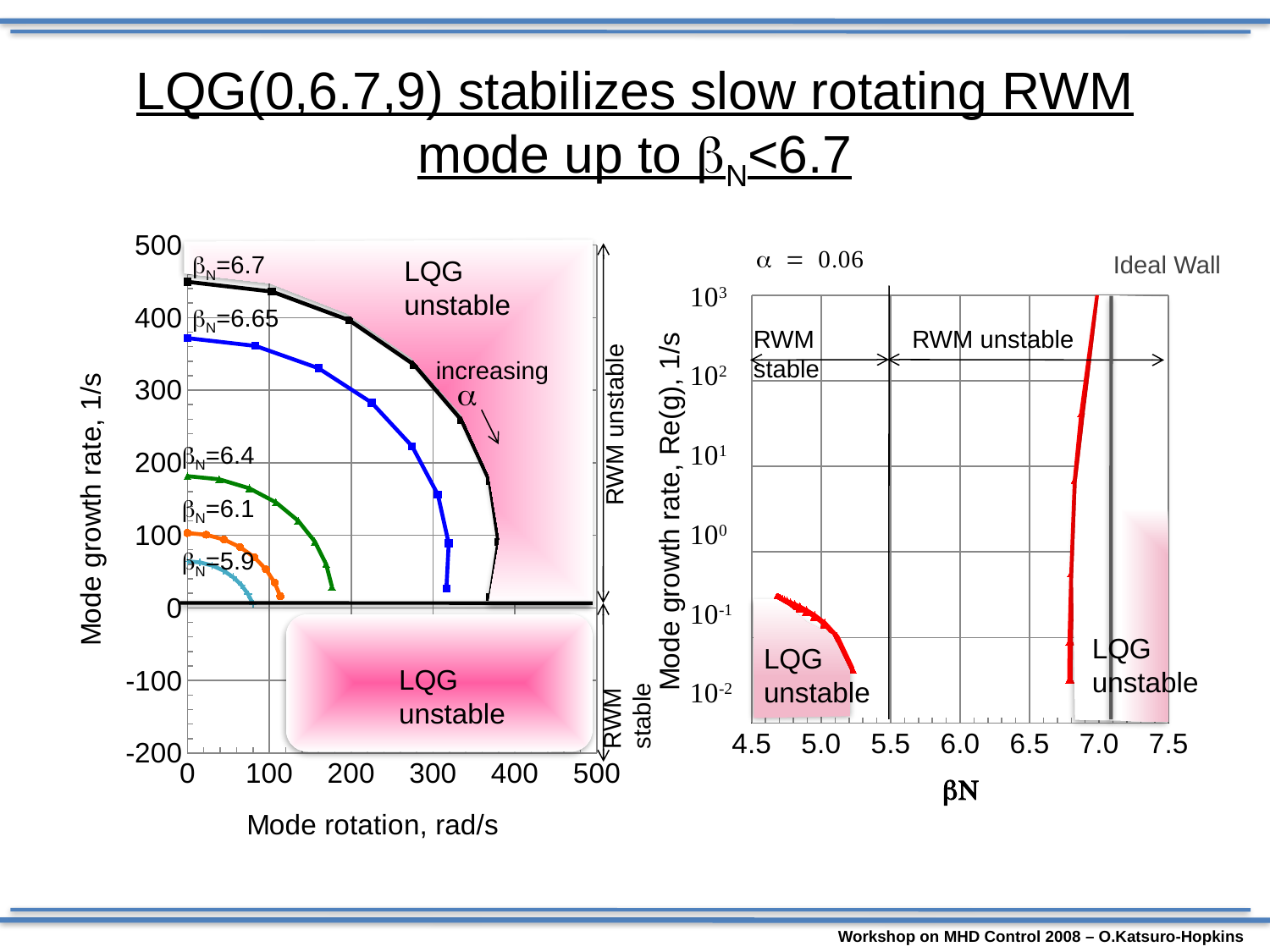
In the left chart, which βN curve has the highest mode growth rate at zero mode rotation? βN=6.7 In the left chart, which curve reaches a larger mode rotation before its growth rate drops to zero: βN=6.65 or βN=6.1? βN=6.65 In the right chart, what value of α is stated above the plot? α = 0.06 In the left chart, is the mode growth rate of the βN=5.9 curve at zero rotation greater or less than 100? less In the left chart (Mode growth rate vs Mode rotation), what kind of chart is shown? line chart In the left chart, does the mode growth rate of each βN curve rise or fall as mode rotation increases? fall In the left chart, how many βN curves are plotted? 5 In the left chart, is the mode growth rate of the βN=6.7 curve at zero rotation greater or less than 400? greater In the right chart (Mode growth rate Re(g) vs βN), does the red curve near βN=7 rise or fall as βN increases? rise In the left chart, what is the label of the x axis? Mode rotation, rad/s In the left chart, is the mode growth rate of the βN=6.4 curve at zero rotation greater or less than 200? less In the left chart, which βN curve has the lowest mode growth rate at zero mode rotation? βN=5.9